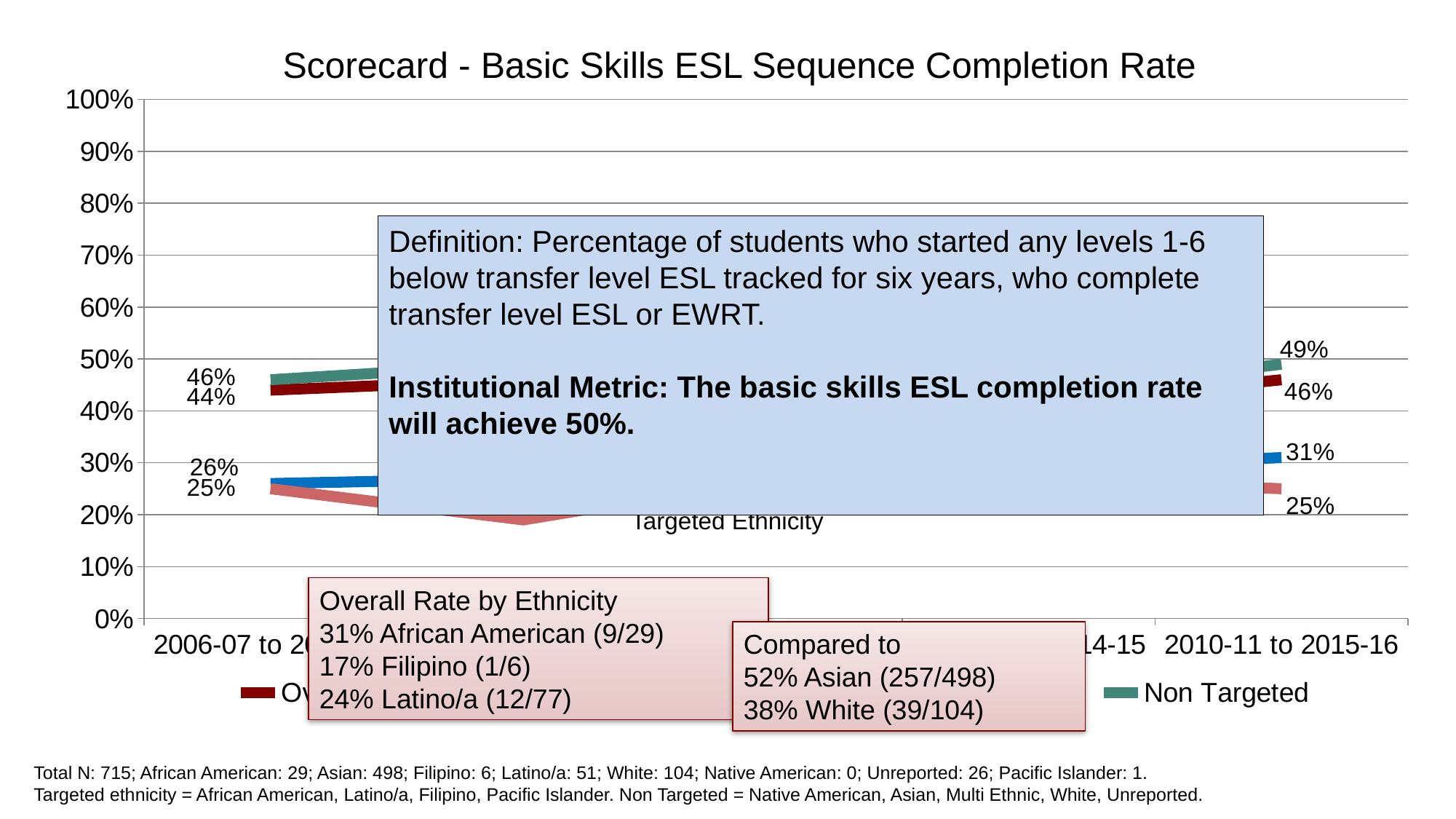
What is the Non Targeted value for 2010-11 to 2015-16? 49% Is the Non Targeted value for 2010-11 to 2015-16 greater or less than 40%? greater What is the Non Targeted value for the first period on the x axis? 46% Does the Non Targeted line rise or fall from the first period to 2010-11 to 2015-16? rises How many data labels are shown for 2010-11 to 2015-16? 4 By how many percentage points does the Non Targeted value change from the first period to 2010-11 to 2015-16? 3 percentage points What is the difference between the highest and lowest labelled values for 2010-11 to 2015-16? 24 percentage points What is the lowest value labelled for the first period on the x axis? 25% What is the lowest value labelled for 2010-11 to 2015-16? 25% What kind of chart is shown on the slide? line chart What is the highest value labelled for 2010-11 to 2015-16? 49% What is the title of the chart? Scorecard - Basic Skills ESL Sequence Completion Rate